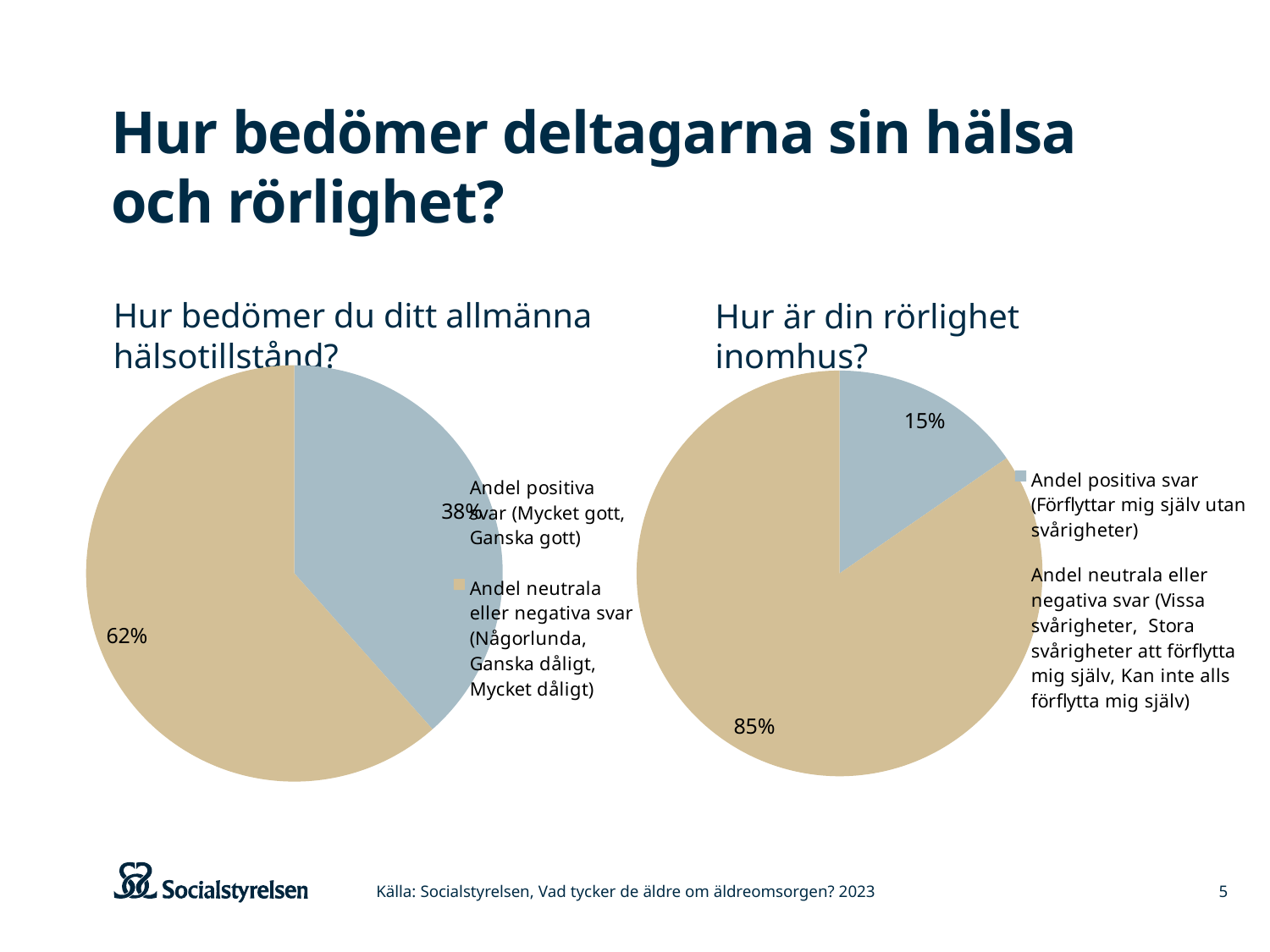
In the chart 'Hur bedömer du ditt allmänna hälsotillstånd?', what is the difference in percentage points between the neutral/negative share and the positive share? 24 percentage points How many slices does the chart 'Hur bedömer du ditt allmänna hälsotillstånd?' have? 2 Which chart shows a larger share of positive answers: 'Hur bedömer du ditt allmänna hälsotillstånd?' or 'Hur är din rörlighet inomhus?'? Hur bedömer du ditt allmänna hälsotillstånd? In the chart 'Hur bedömer du ditt allmänna hälsotillstånd?', which category has the largest slice? Andel neutrala eller negativa svar In the chart 'Hur bedömer du ditt allmänna hälsotillstånd?', what share of answers are positive (Andel positiva svar)? 38% In the chart 'Hur är din rörlighet inomhus?', what share of answers are positive (Andel positiva svar)? 15% In the chart 'Hur är din rörlighet inomhus?', what is the difference in percentage points between the neutral/negative share and the positive share? 70 percentage points What type of chart is used for 'Hur är din rörlighet inomhus?'? Pie chart In the chart 'Hur är din rörlighet inomhus?', which category has the smallest slice? Andel positiva svar In the chart 'Hur bedömer du ditt allmänna hälsotillstånd?', what share of answers are neutral or negative (Andel neutrala eller negativa svar)? 62% In the chart 'Hur är din rörlighet inomhus?', what colour is the slice for 'Andel positiva svar'? Blue In the chart 'Hur är din rörlighet inomhus?', what share of answers are neutral or negative (Andel neutrala eller negativa svar)? 85%